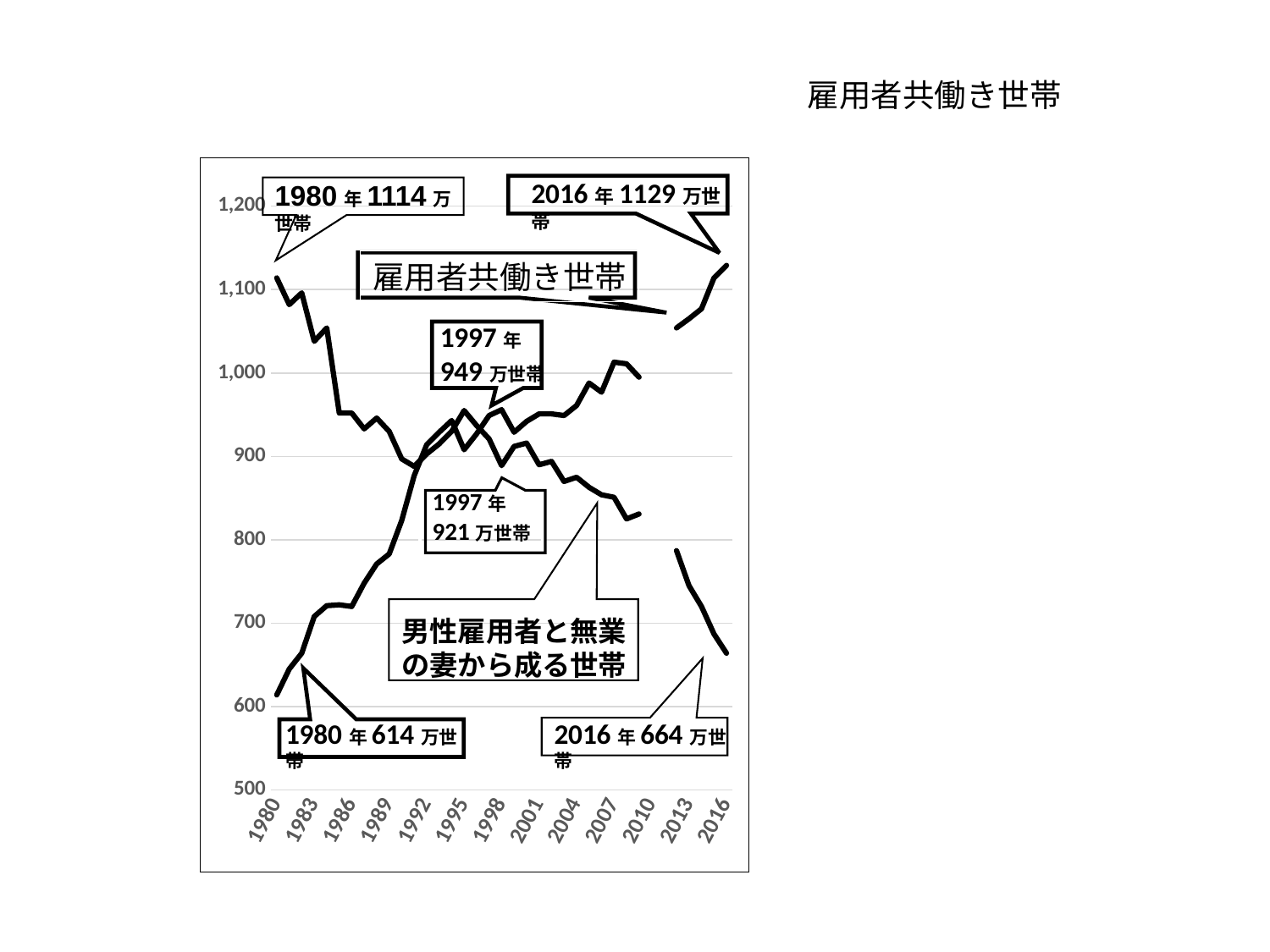
What is the difference between the 2016 values of 雇用者共働き世帯 and 男性雇用者と無業の妻から成る世帯? 465万世帯 Which series has the larger value in 1980? 男性雇用者と無業の妻から成る世帯 What is the value for 雇用者共働き世帯 in 2016? 1129万世帯 What kind of chart is shown on the slide? line chart What is the difference between the 1980 values of 男性雇用者と無業の妻から成る世帯 and 雇用者共働き世帯? 500万世帯 Does the 雇用者共働き世帯 line generally rise or fall from 1980 to 2016? rise What is the difference between the two series' values in 1997 (949万世帯 and 921万世帯)? 28万世帯 What is the value for 男性雇用者と無業の妻から成る世帯 in 1980? 1114万世帯 Which series has the larger value in 2016? 雇用者共働き世帯 What is the value for 男性雇用者と無業の妻から成る世帯 in 2016? 664万世帯 What is the value for 雇用者共働き世帯 in 1980? 614万世帯